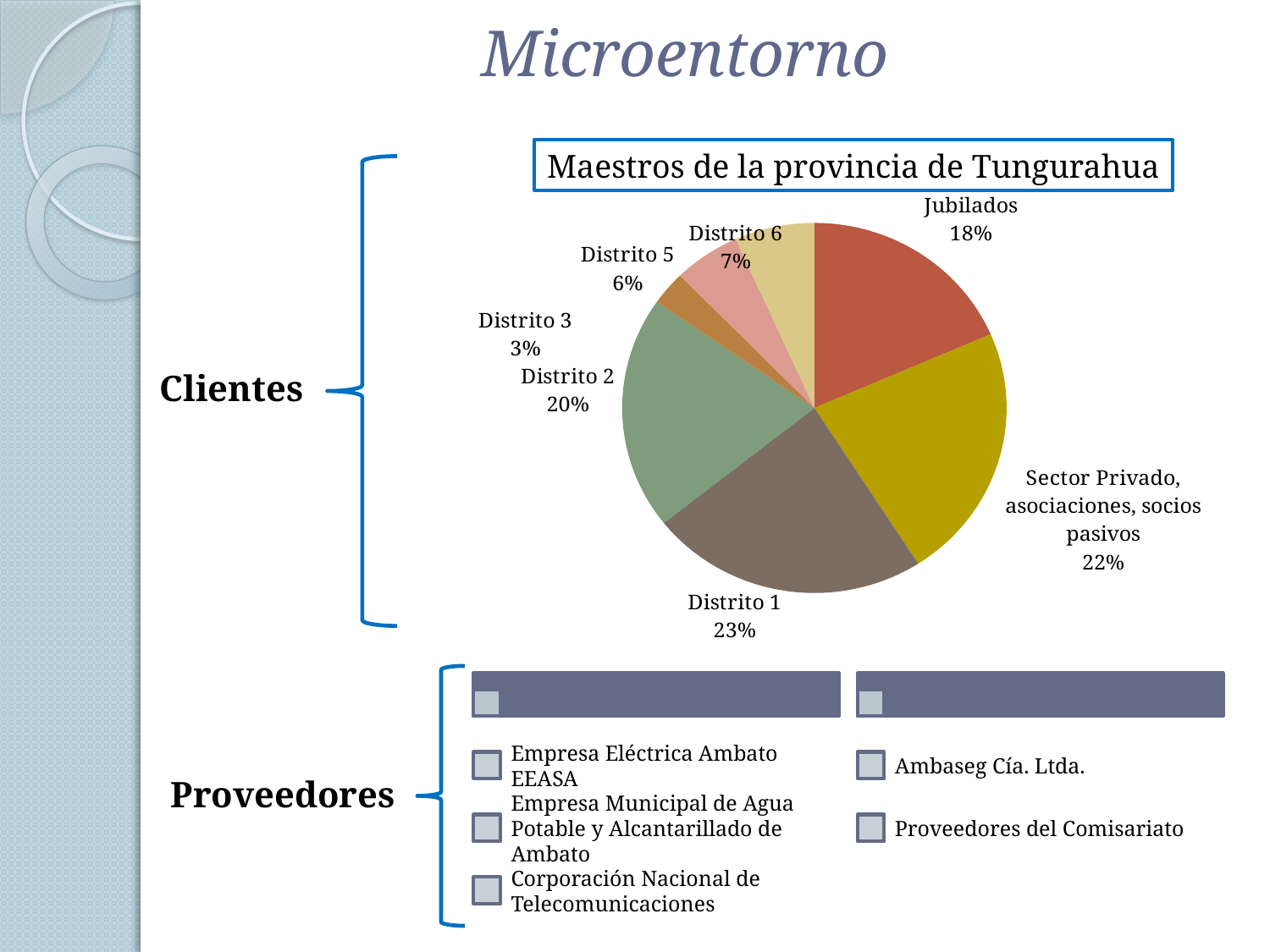
What percentage is shown for Distrito 5? 6% What percentage is shown for Distrito 1? 23% Which category has the smallest share of the pie? Distrito 3 How many slices does the pie chart have? 7 Which is larger, the share for Distrito 6 or the share for Distrito 5? Distrito 6 What percentage of the pie does Jubilados represent? 18% What percentage is shown for Sector Privado, asociaciones, socios pasivos? 22% What kind of chart is shown on the slide? pie chart What is the title of the pie chart? Maestros de la provincia de Tungurahua What is the difference in percentage points between Distrito 1 and Distrito 2? 3 Which category has the largest share of the pie? Distrito 1 What percentage is shown for Distrito 2? 20%